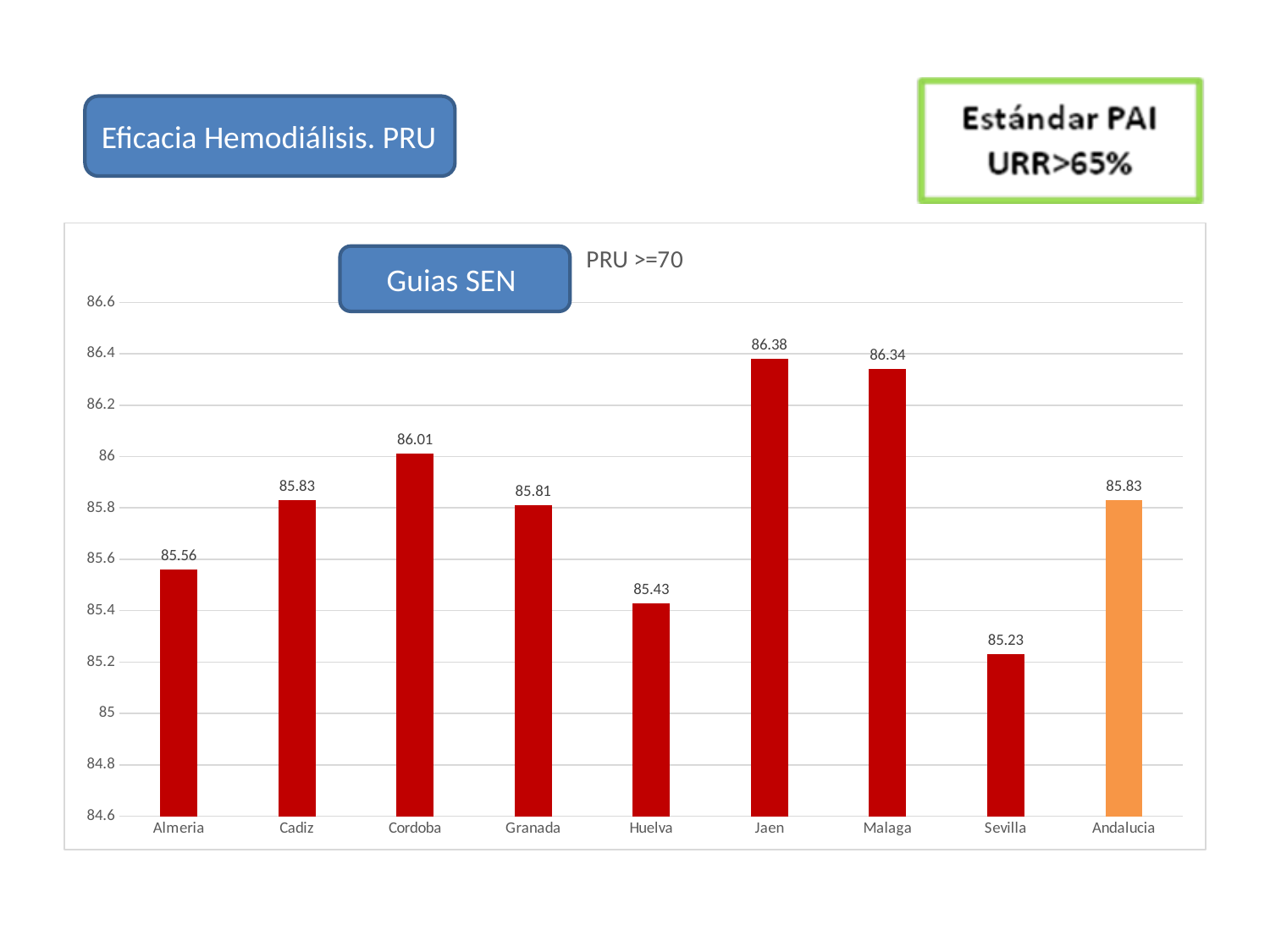
What is the value for Sevilla? 85.23 Which category has the lowest value? Sevilla What is the difference between the values for Cordoba and Almeria? 0.45 What is the value for Andalucia? 85.83 Is the value for Malaga greater or less than 86? greater What is the value for Jaen? 86.38 Which category has the highest value? Jaen How many categories are shown on the x axis? 9 What is the difference between the values for Jaen and Sevilla? 1.15 Which is larger, the value for Cordoba or the value for Granada? Cordoba What is the value for Huelva? 85.43 What kind of chart is shown on the slide? bar chart